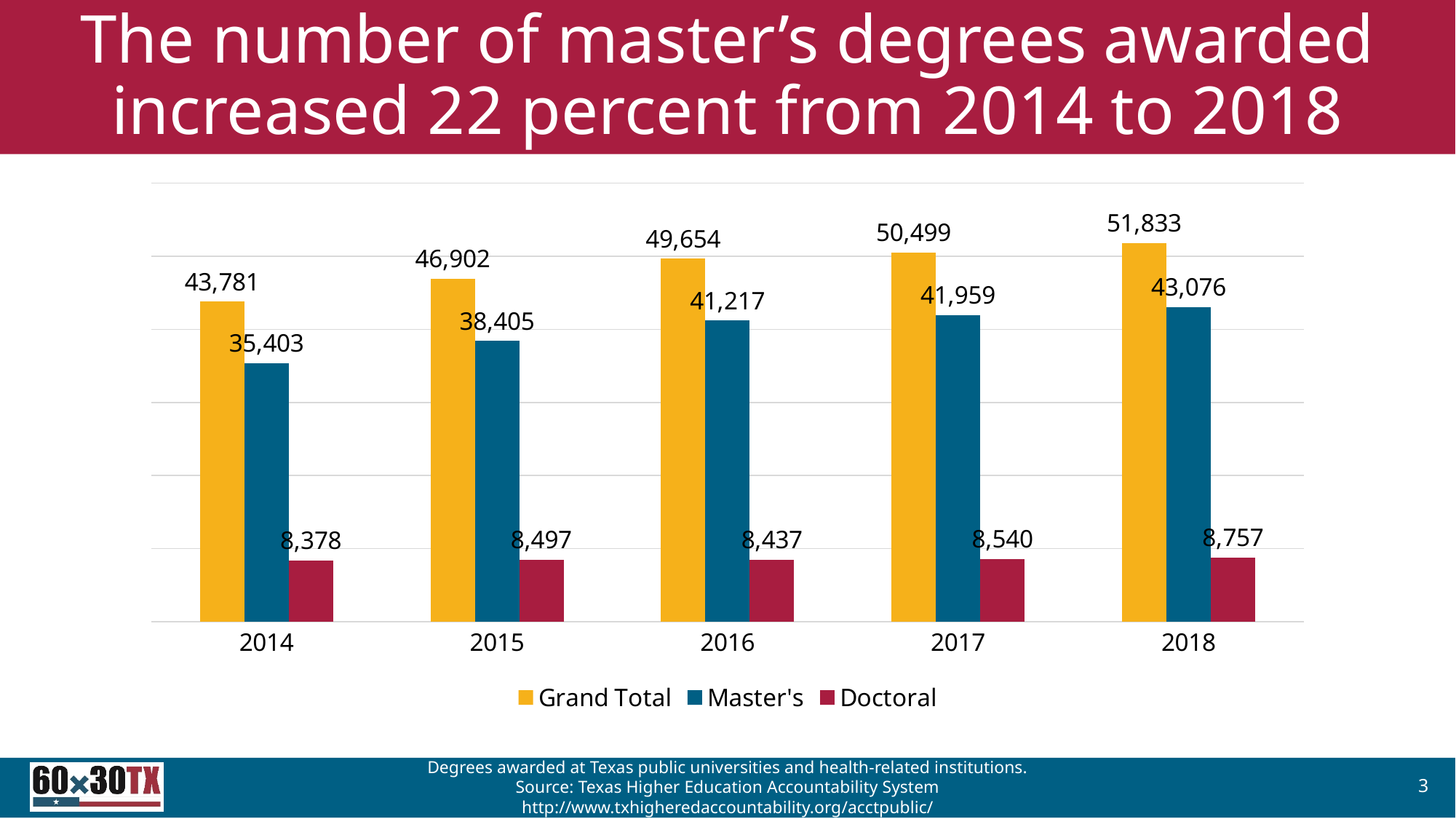
In which year is the Master's value highest? 2018 How many series does the legend list? 3 How many Master's degrees were awarded in 2014? 35,403 How many years are shown on the x axis? 5 What is the Doctoral value for 2018? 8,757 What is the difference between the Master's and Doctoral values in 2017? 33,419 What is the Grand Total value for 2016? 49,654 Do the Grand Total values rise or fall from 2014 to 2018? Rise Which is larger, the Doctoral value for 2015 or the Doctoral value for 2016? 2015 In which year is the Doctoral value lowest? 2014 What kind of chart is shown on the slide? Bar chart What is the difference between the Grand Total values for 2018 and 2014? 8,052